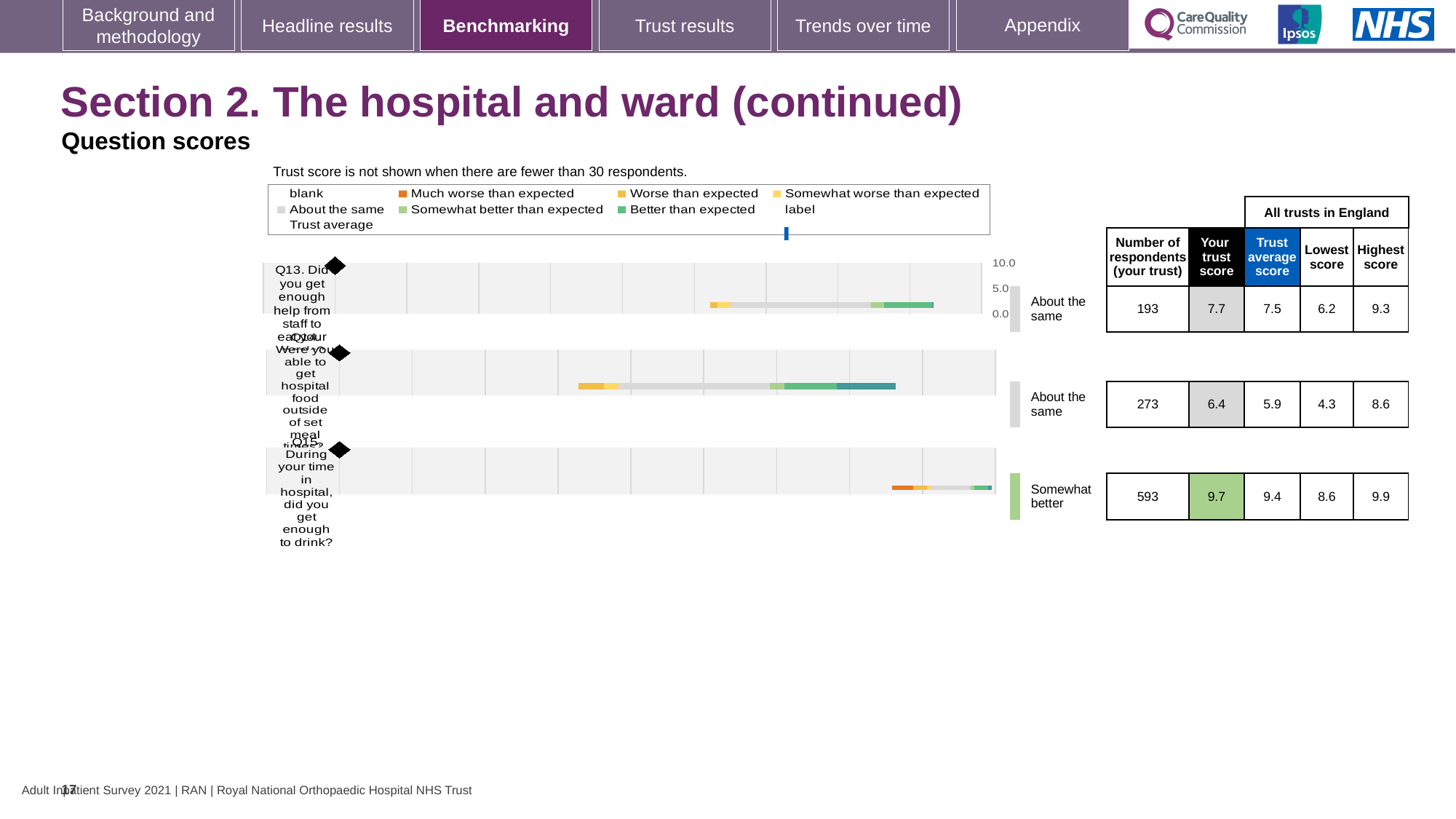
What is the lowest score across all trusts in England for Q14? 4.3 What kind of chart is used to show the question scores? Bar chart Which question has the lowest number of respondents from your trust? Q13 What is the trust average score for Q14 (Were you able to get hospital food outside of set meal times?)? 5.9 What benchmark category is shown next to Q15? Somewhat better Which is larger: your trust score for Q13 or your trust score for Q15? Q15 What is the 'Your trust score' for Q13 (Did you get enough help from staff to eat your meals?)? 7.7 Which question has the highest 'Your trust score'? Q15 What is the highest score across all trusts in England for Q15? 9.9 What is the difference between your trust score and the trust average score for Q14? 0.5 How many questions are plotted in the chart? 3 How many respondents from your trust answered Q15 (did you get enough to drink?)? 593